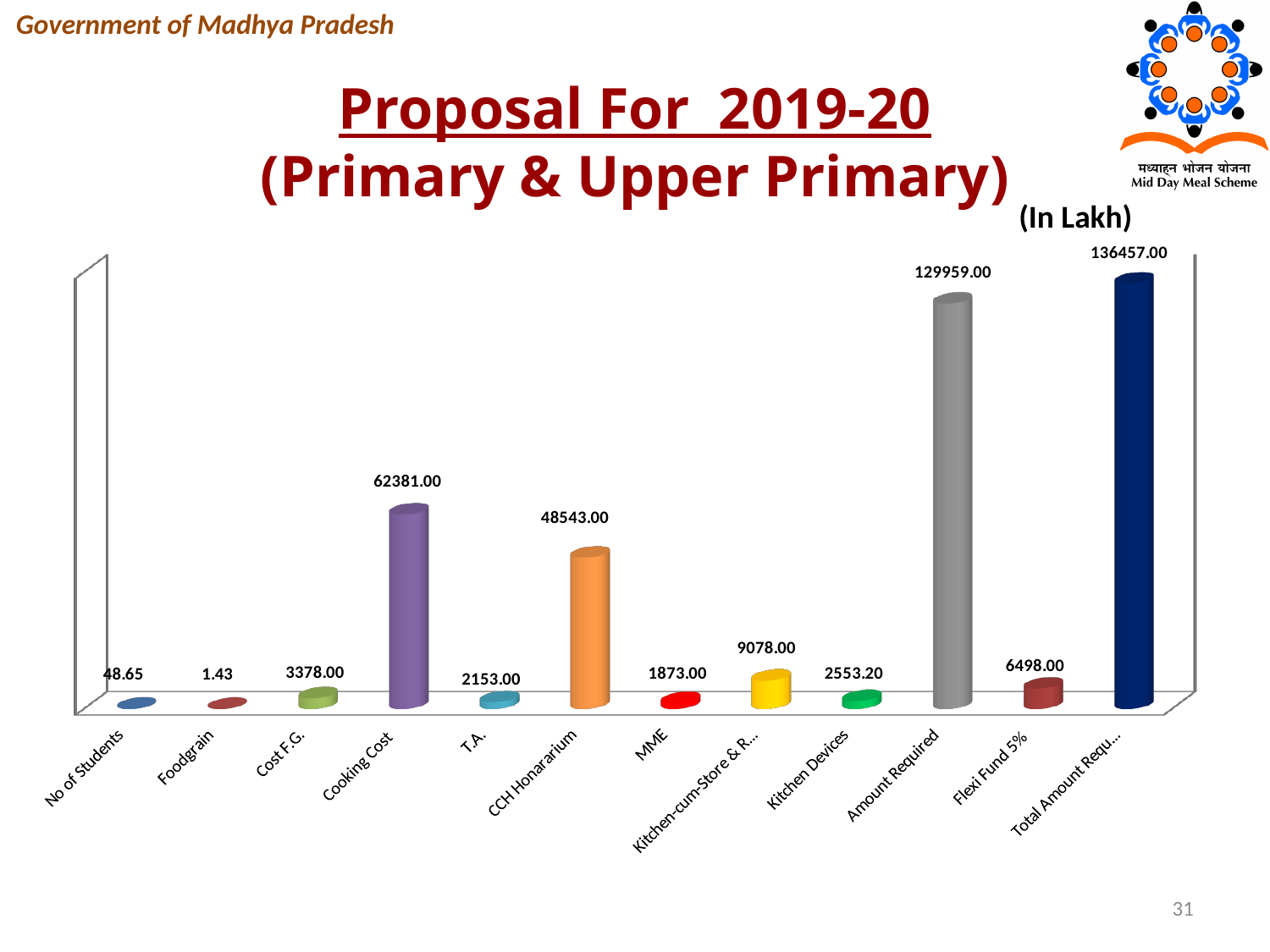
What is the value for CCH Honararium? 48543.00 What kind of chart is shown on the slide? Bar chart What is the value for Kitchen Devices? 2553.20 Which is larger, T.A. or MME? T.A. What is the value for Flexi Fund 5%? 6498.00 What is the value for Amount Required? 129959.00 What is the value for Cooking Cost? 62381.00 Which category has the lowest value? Foodgrain What is the difference between Flexi Fund 5% and Cost F.G.? 3120.00 In what unit are the chart values expressed, according to the slide? In Lakh What is the difference between Cooking Cost and CCH Honararium? 13838.00 How many categories are shown on the x axis? 12